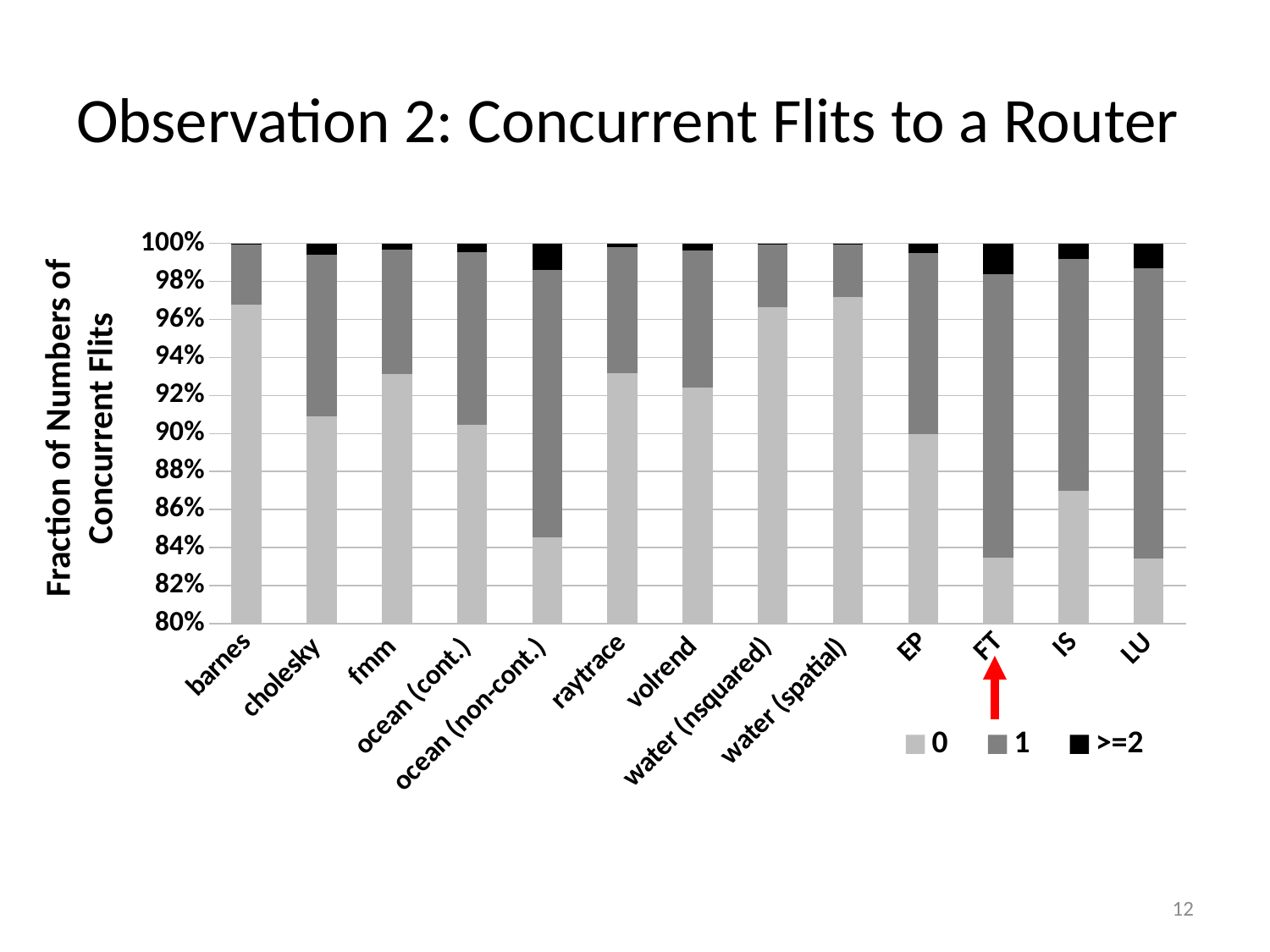
What are the series names listed in the legend? 0, 1, >=2 How many series does the legend list? 3 Which category is marked with a red arrow below the x axis? FT Is the value of the "0" series for barnes greater or less than 94%? greater What is the total height of the stacked bar for barnes? 100% Which has a larger "0" share, fmm or LU? fmm Is the value of the "0" series for ocean (non-cont.) greater or less than 86%? less Is the value of the "0" series for FT greater or less than 86%? less Which has a larger "0" share, barnes or FT? barnes What kind of chart is shown on the slide? stacked bar chart How many categories are shown along the x axis? 13